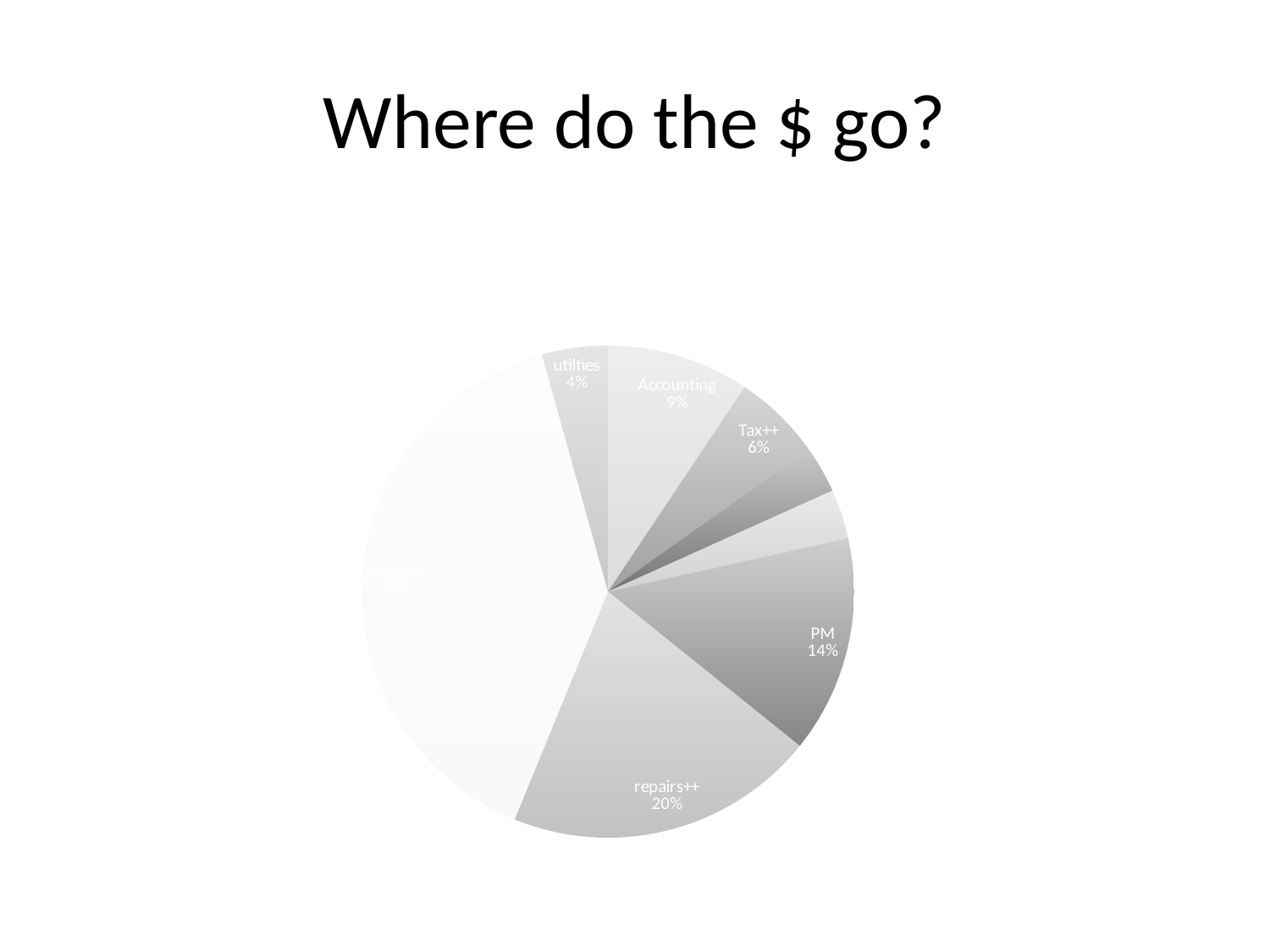
What percentage of the pie does the repairs++ slice represent? 20% What is the difference in percentage points between the PM slice and the utilities slice? 10 percentage points What kind of chart is shown on the slide? Pie chart What percentage is shown for the Accounting slice? 9% What percentage is shown for the utilities slice? 4% What is the title of the slide containing the chart? Where do the $ go? Which slice is larger, repairs++ or PM? repairs++ By how many percentage points does the repairs++ slice exceed the PM slice? 6 percentage points Which slice is larger, Accounting or Tax++? Accounting What is the difference in percentage points between the Accounting slice and the Tax++ slice? 3 percentage points What percentage is shown for the Tax++ slice? 6% What share of the pie is labelled PM? 14%